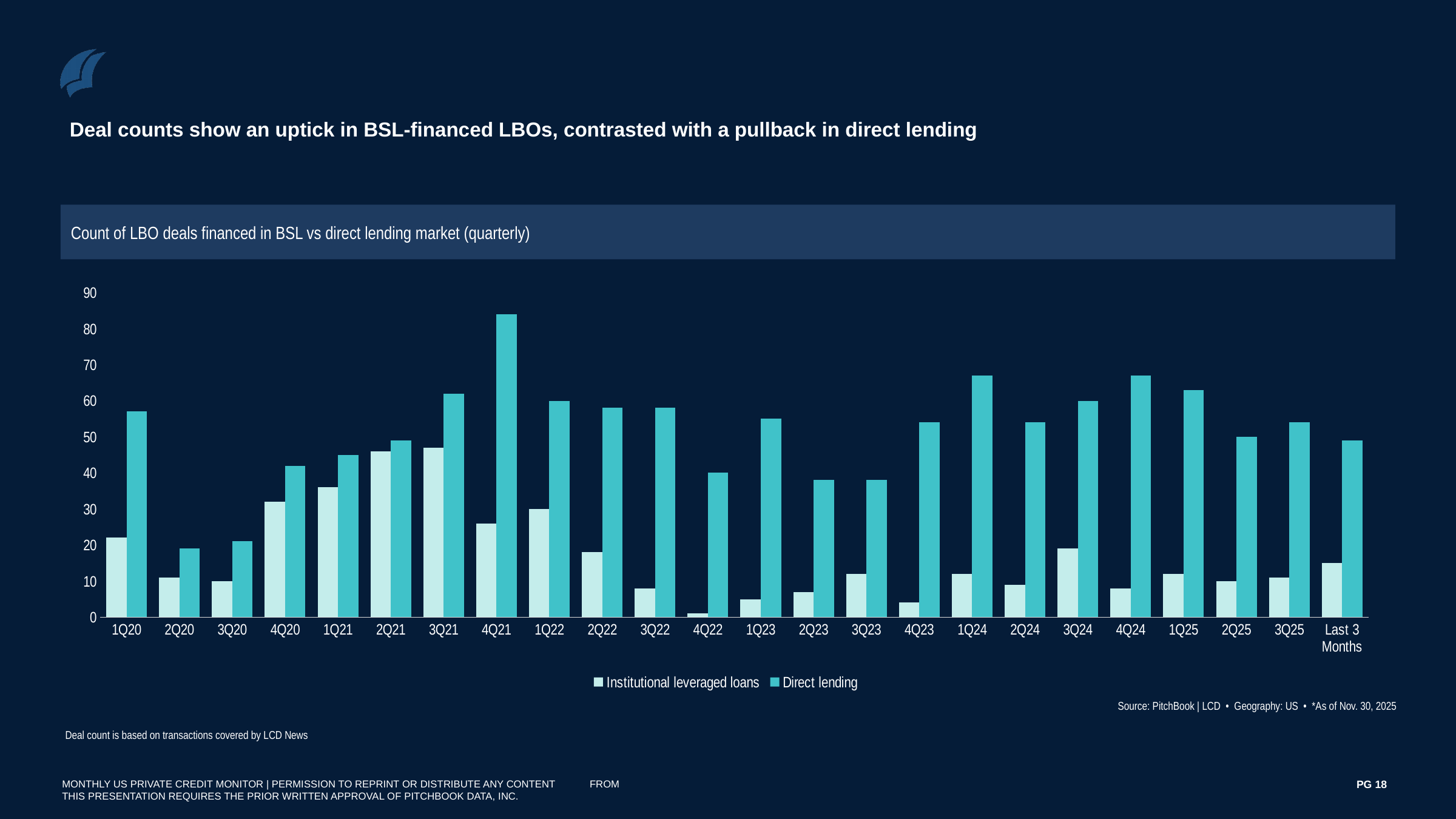
Is the Institutional leveraged loans value for 4Q21 greater or less than 30? less Do the Direct lending values rise or fall from 4Q20 to 4Q21? rise What kind of chart is shown on the slide? Bar chart In which quarter is the Direct lending deal count highest? 4Q21 Is the Direct lending value for 1Q24 greater or less than 60? greater What are the two series named in the legend? Institutional leveraged loans and Direct lending In which quarter is the Institutional leveraged loans deal count lowest? 4Q22 Is the Direct lending value for 4Q21 greater or less than 80? greater Which is larger: the Direct lending value for 4Q24 or for 3Q25? 4Q24 How many series does the legend list? 2 How many categories are shown along the x axis? 24